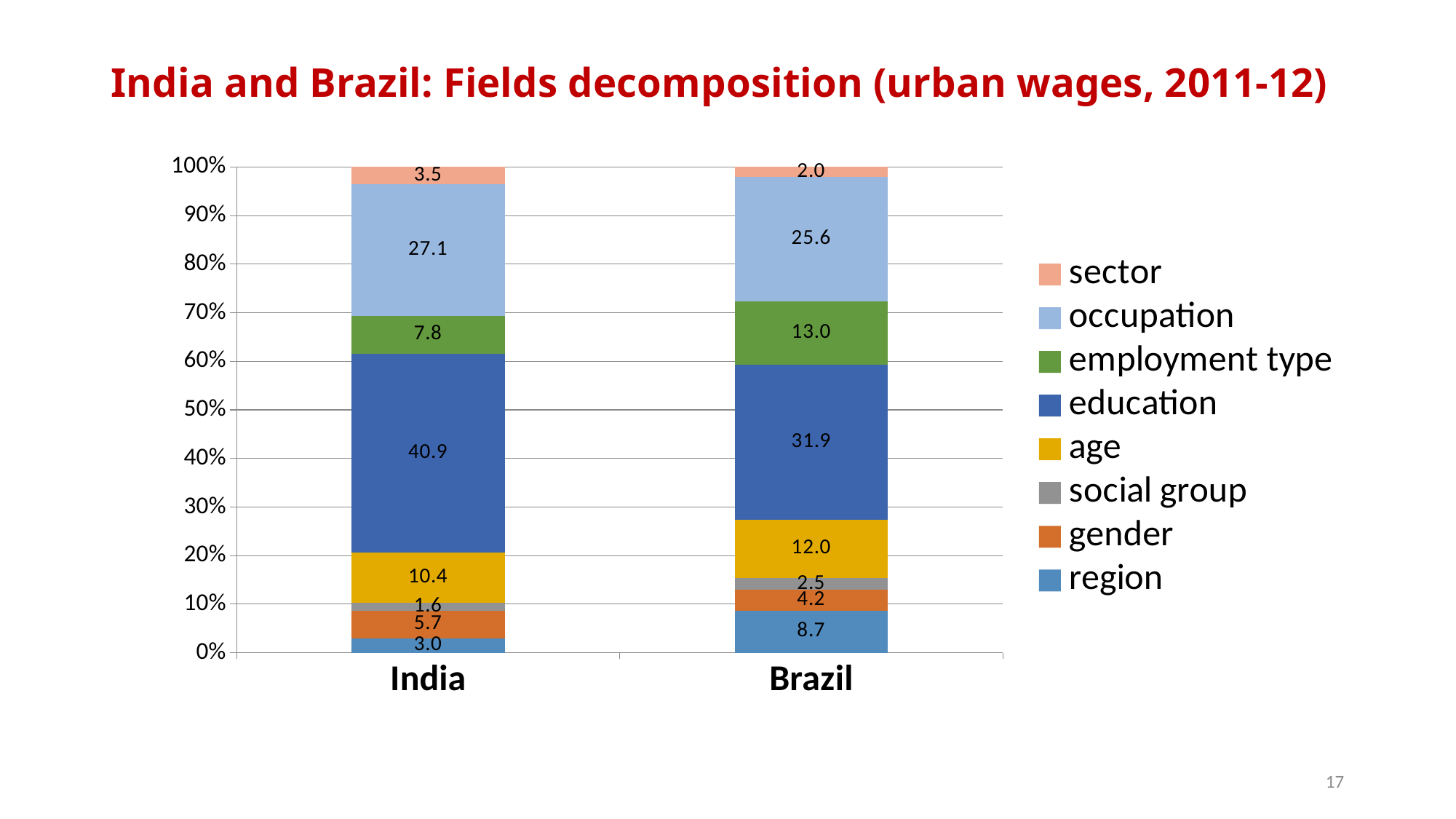
What is the title of the chart? India and Brazil: Fields decomposition (urban wages, 2011-12) What is the value of the sector segment for India? 3.5 Which series has the largest segment in the India bar? education What is the value of the occupation segment for Brazil? 25.6 Which series has the smallest segment in the India bar? social group What is the value of the education segment for India? 40.9 How many countries are shown on the x axis? 2 How many series does the legend list? 8 What is the value of the region segment for Brazil? 8.7 What is the difference between the education values for India and Brazil? 9.0 Which country has the larger employment type value, India or Brazil? Brazil What kind of chart is shown on the slide? stacked bar chart